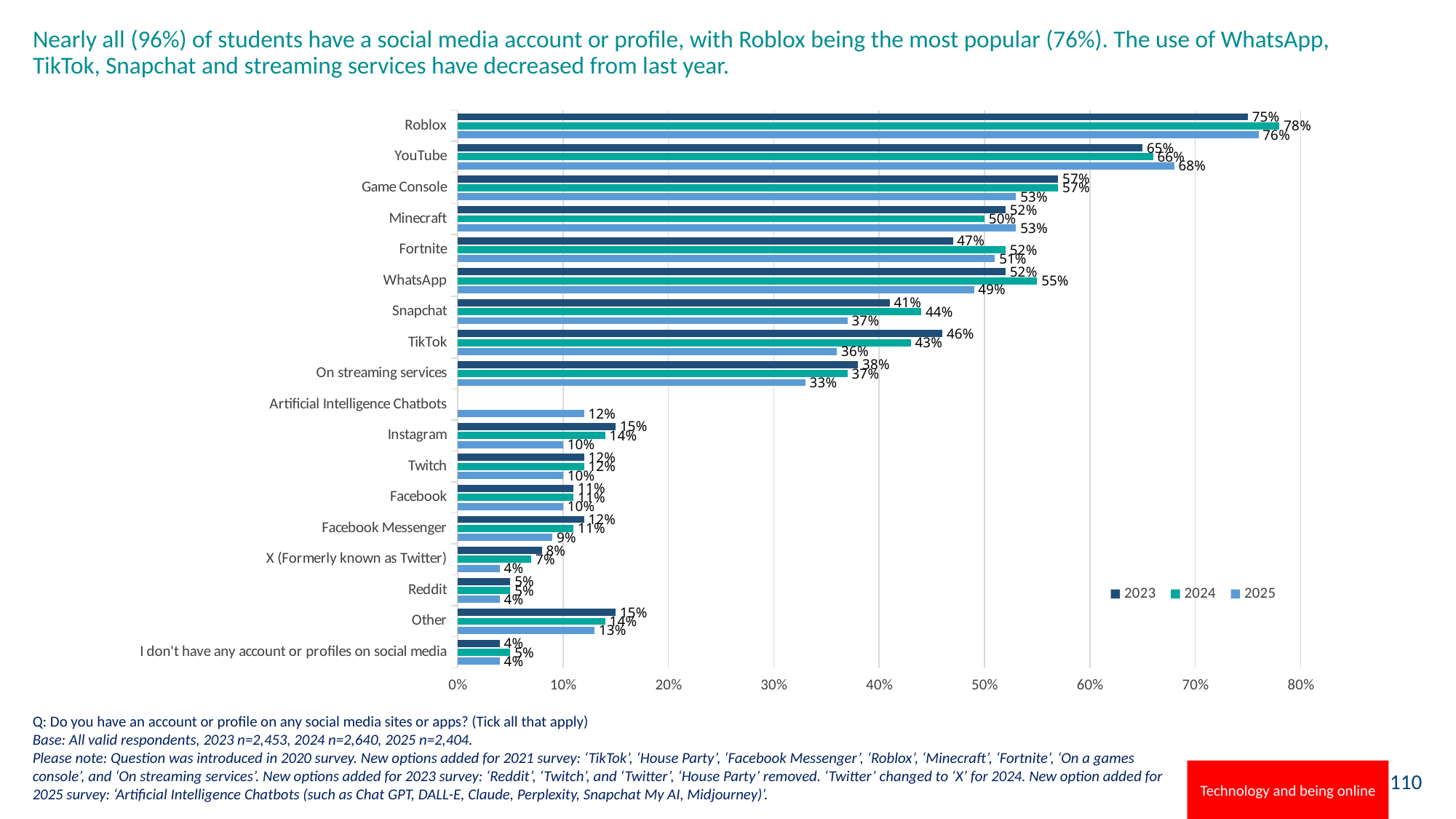
What is the 2024 value for WhatsApp? 55% What is the 2025 value for Artificial Intelligence Chatbots? 12% What is the difference between the 2024 and 2025 values for Snapchat? 7% Which category has the highest 2024 value? Roblox What is the 2025 value for Roblox? 76% Which category has the lowest 2023 value? I don't have any account or profiles on social media How many categories are shown on the y axis of the chart? 18 What is the 2023 value for TikTok? 46% Do the values for On streaming services rise or fall from 2023 to 2025? fall How many series does the legend list? 3 What kind of chart is shown on the slide? bar chart Which is larger for YouTube, the 2023 value or the 2025 value? 2025